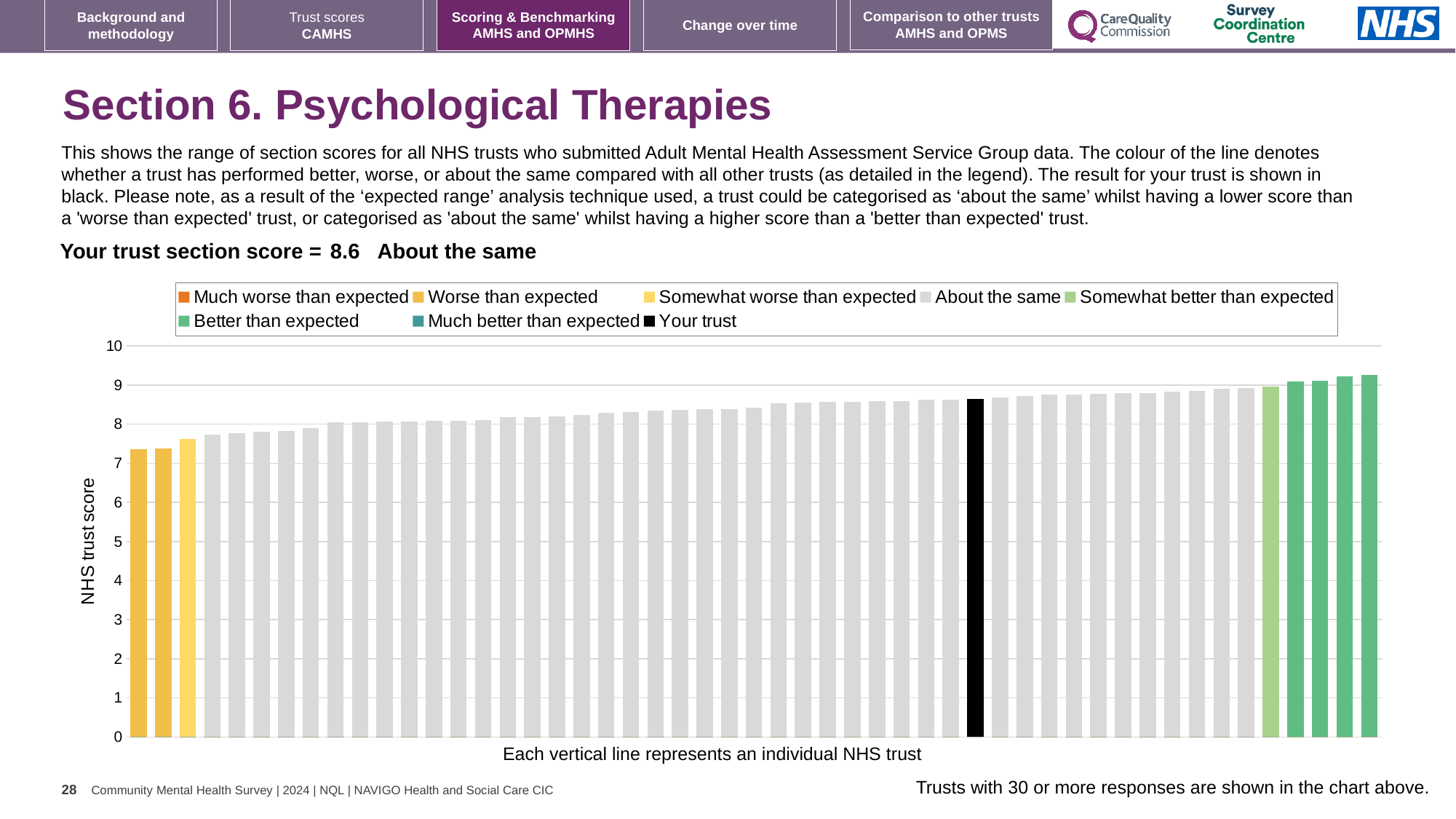
Is the value of the black 'Your trust' bar greater or less than 8? greater Is the value of the rightmost (highest) bar greater or less than 9? greater Do the bar values rise or fall from left to right along the x axis? rise Which legend category does the lowest bar in the chart belong to? Worse than expected Is the value of the leftmost (lowest) bar greater or less than 8? less How many entries does the chart legend list? 8 What is the section score for your trust shown on the slide? 8.6 What kind of chart is shown on the slide? bar chart How many bars are coloured as 'Better than expected' (dark green)? 4 What is the label on the vertical axis of the chart? NHS trust score Which legend category does the highest bar in the chart belong to? Better than expected What colour is the bar representing your trust? black